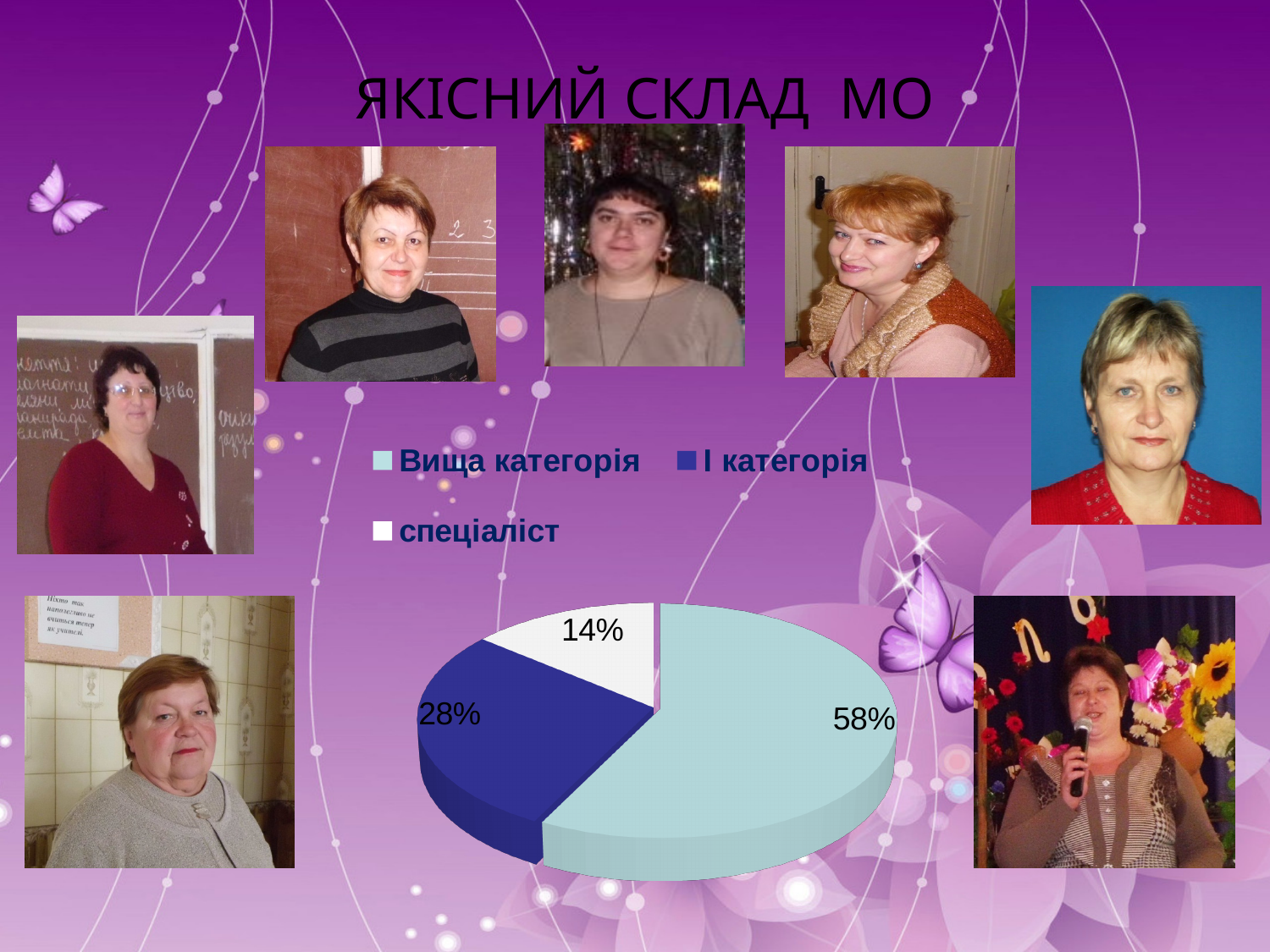
Which is larger, the slice for "І категорія" or the slice for "спеціаліст"? І категорія What kind of chart is shown on the slide? pie chart Which category has the smallest slice of the pie? спеціаліст What share of the pie does "І категорія" have? 28% What is the difference in percentage points between "І категорія" and "спеціаліст"? 14 What share of the pie does "Вища категорія" have? 58% How many slices does the pie chart have? 3 What share of the pie does "спеціаліст" have? 14% What is the difference in percentage points between "Вища категорія" and "І категорія"? 30 How many entries does the chart legend list? 3 What colour is the slice for "І категорія"? dark blue Which category has the largest slice of the pie? Вища категорія